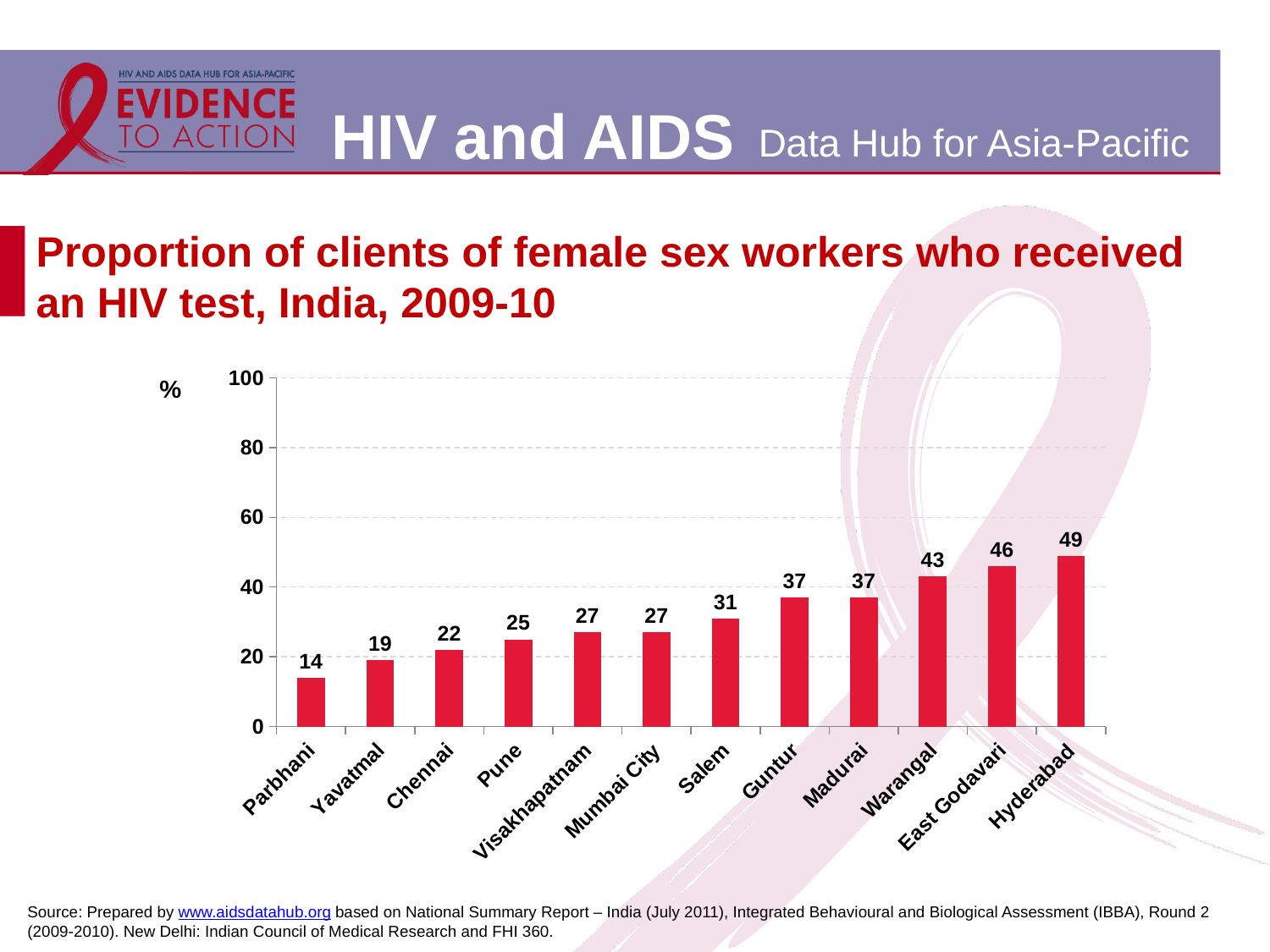
Do the values generally rise or fall from left to right along the x axis? Rise Which is larger, the value for East Godavari or the value for Guntur? East Godavari Which city has the highest proportion of clients who received an HIV test? Hyderabad What kind of chart is shown on the slide? Bar chart What is the value for Parbhani? 14 What is the difference between the values for Warangal and Chennai? 21 What is the difference between the values for Hyderabad and Parbhani? 35 Which city has the lowest proportion of clients who received an HIV test? Parbhani What is the value for Hyderabad? 49 How many cities are shown on the chart? 12 Is the value for Madurai greater or less than 40? less What is the value for Salem? 31